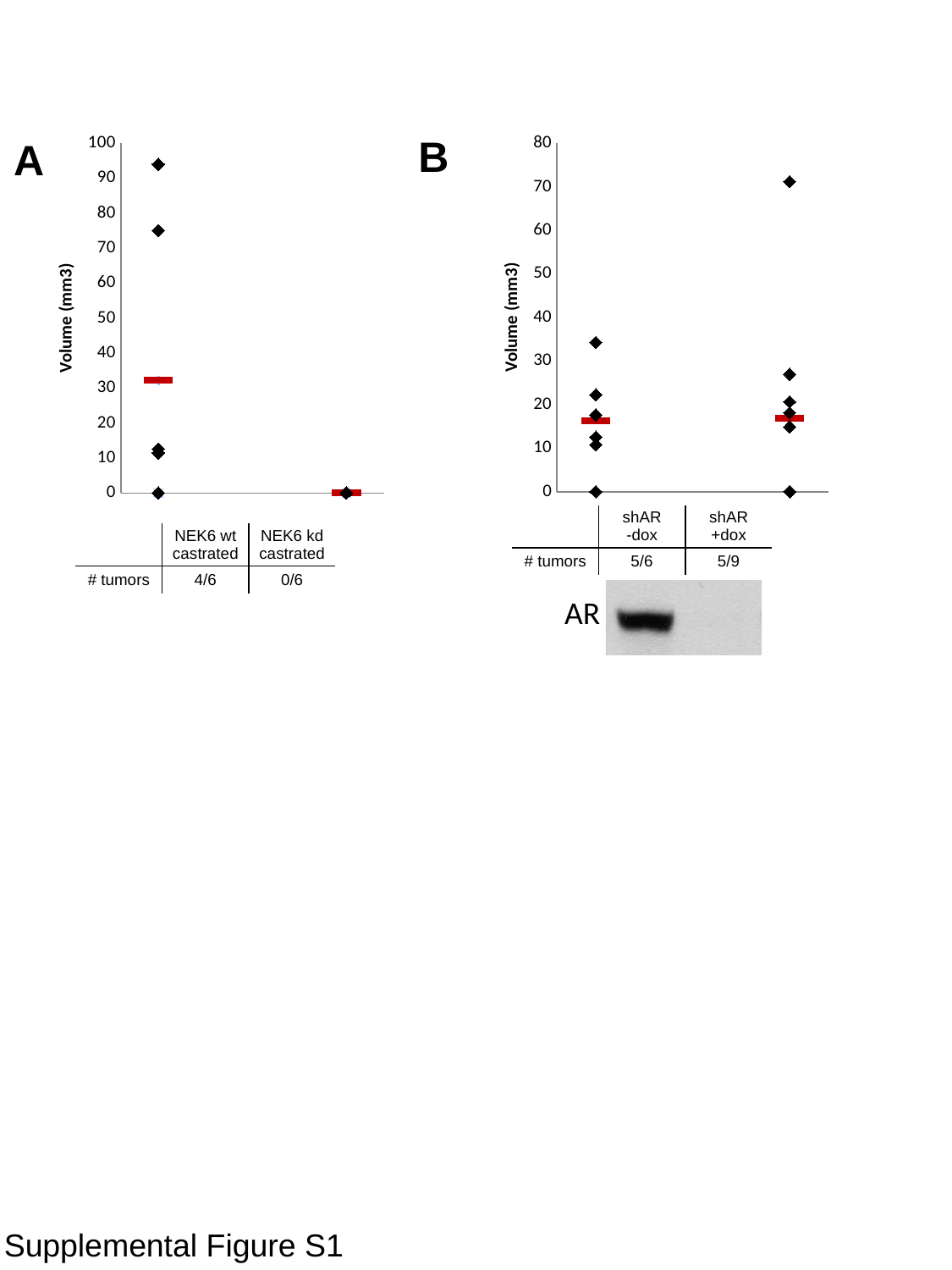
What kind of chart is chart A (the left chart)? scatter (dot) plot In chart A (the left chart), how many groups are plotted along the x axis? 2 In chart B (the right chart), what is the # tumors value shown for shAR -dox? 5/6 In chart B (the right chart), what is the highest value shown on the y axis? 80 In chart B (the right chart), is the highest point for shAR +dox greater or less than 60? greater In chart A (the left chart), which group has the higher red bar (median volume), NEK6 wt castrated or NEK6 kd castrated? NEK6 wt castrated In chart A (the left chart), what is the # tumors value shown for NEK6 wt castrated? 4/6 In chart A (the left chart), is the highest point for NEK6 wt castrated greater or less than 90? greater In chart A (the left chart), what is the # tumors value shown for NEK6 kd castrated? 0/6 In chart B (the right chart), what is the # tumors value shown for shAR +dox? 5/9 In chart A (the left chart), what is the y-axis title? Volume (mm3) In chart B (the right chart), is the highest point for shAR -dox greater or less than 40? less